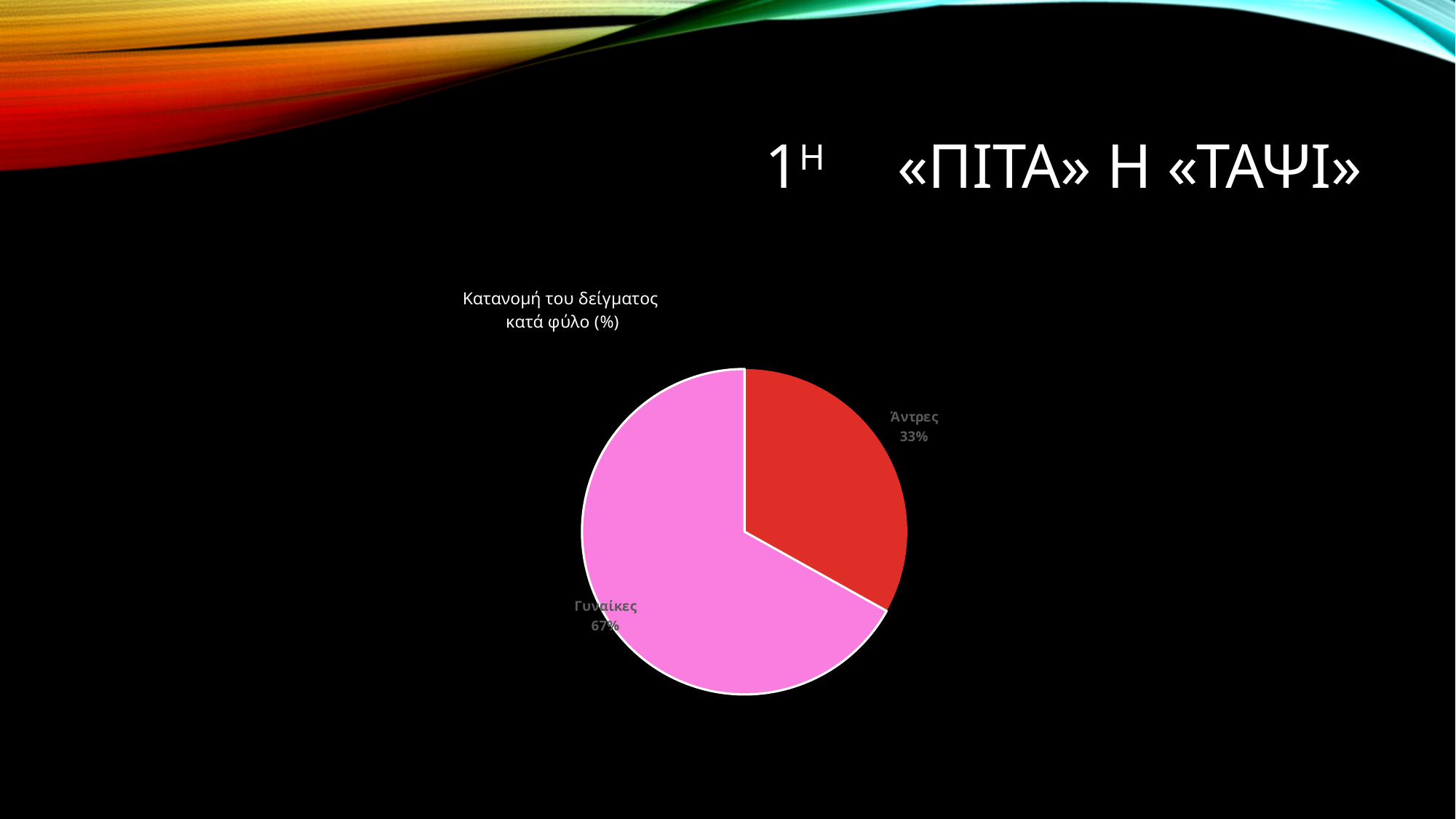
Which is larger, the share for Άντρες or the share for Γυναίκες? Γυναίκες What kind of chart is shown on the slide? Pie chart Which category has the largest share of the pie? Γυναίκες How many categories does the pie chart show? 2 What percentage of the sample is Άντρες (men)? 33% Which category has the smallest share of the pie? Άντρες What is the difference in percentage points between Γυναίκες and Άντρες? 34 What colour is the Γυναίκες slice? Pink What is the title of the chart? Κατανομή του δείγματος κατά φύλο (%) What share of the pie does the Άντρες slice represent? 33% What percentage of the sample is Γυναίκες (women)? 67%